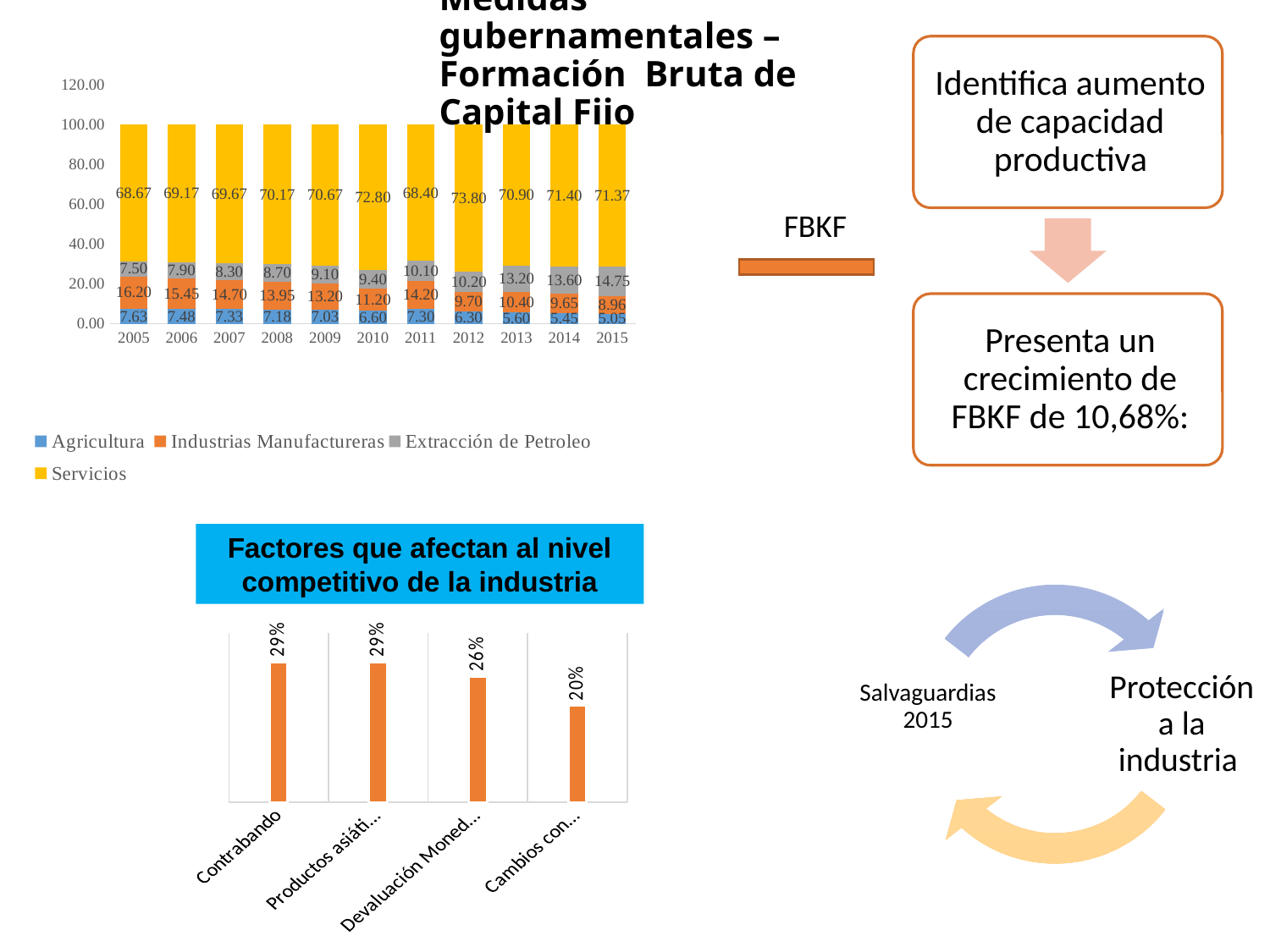
In the stacked bar chart at the top left, what is the value for Servicios in 2010? 72.80 In the stacked bar chart at the top left, what is the value for Extracción de Petroleo in 2015? 14.75 In the stacked bar chart at the top left, what is the difference between the Industrias Manufactureras values for 2005 and 2015? 7.24 In the chart titled 'Factores que afectan al nivel competitivo de la industria', what is the value for Contrabando? 29% In the stacked bar chart at the top left, how many years are shown on the x axis? 11 What kind of chart is 'Factores que afectan al nivel competitivo de la industria'? bar chart In the stacked bar chart at the top left, which year has the lowest value for Agricultura? 2015 In the stacked bar chart at the top left, does the Agricultura value rise or fall from 2005 to 2015? fall In the stacked bar chart at the top left, how many series does the legend list? 4 In the stacked bar chart at the top left, what is the value for Agricultura in 2005? 7.63 In the stacked bar chart at the top left, what is the value for Industrias Manufactureras in 2008? 13.95 In the stacked bar chart at the top left, which year has the highest value for Servicios? 2012